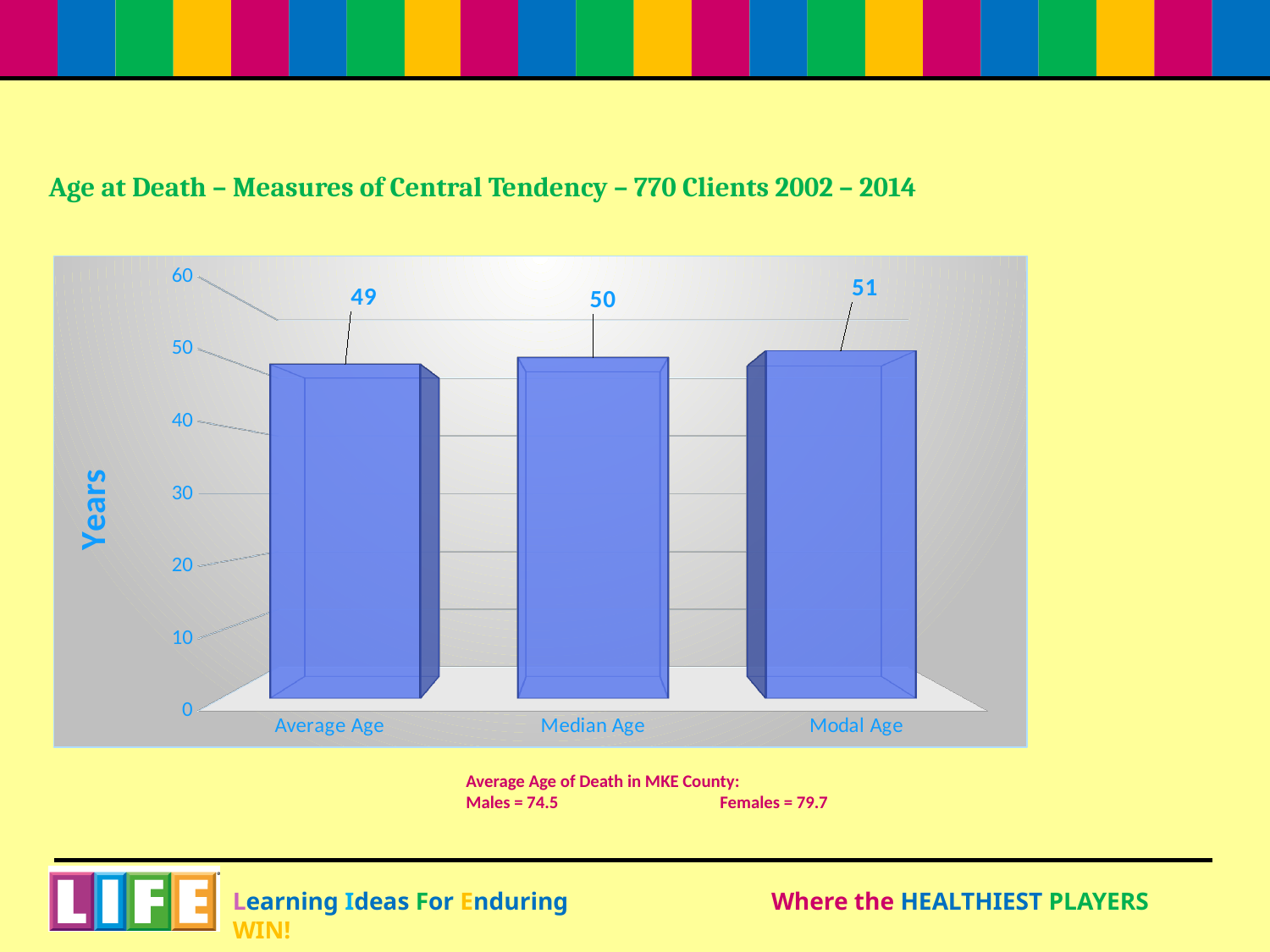
What is the value for Average Age? 49 How many categories are shown on the chart? 3 Is the value for Modal Age greater or less than 40? greater Which is larger, the Median Age or the Average Age? Median Age Do the values rise or fall from Average Age to Modal Age? rise Which category has the lowest value? Average Age What kind of chart is shown on the slide? bar chart Which category has the highest value? Modal Age What is the label on the vertical axis of the chart? Years What is the value for Median Age? 50 What is the difference between the Modal Age and the Average Age? 2 What is the value for Modal Age? 51